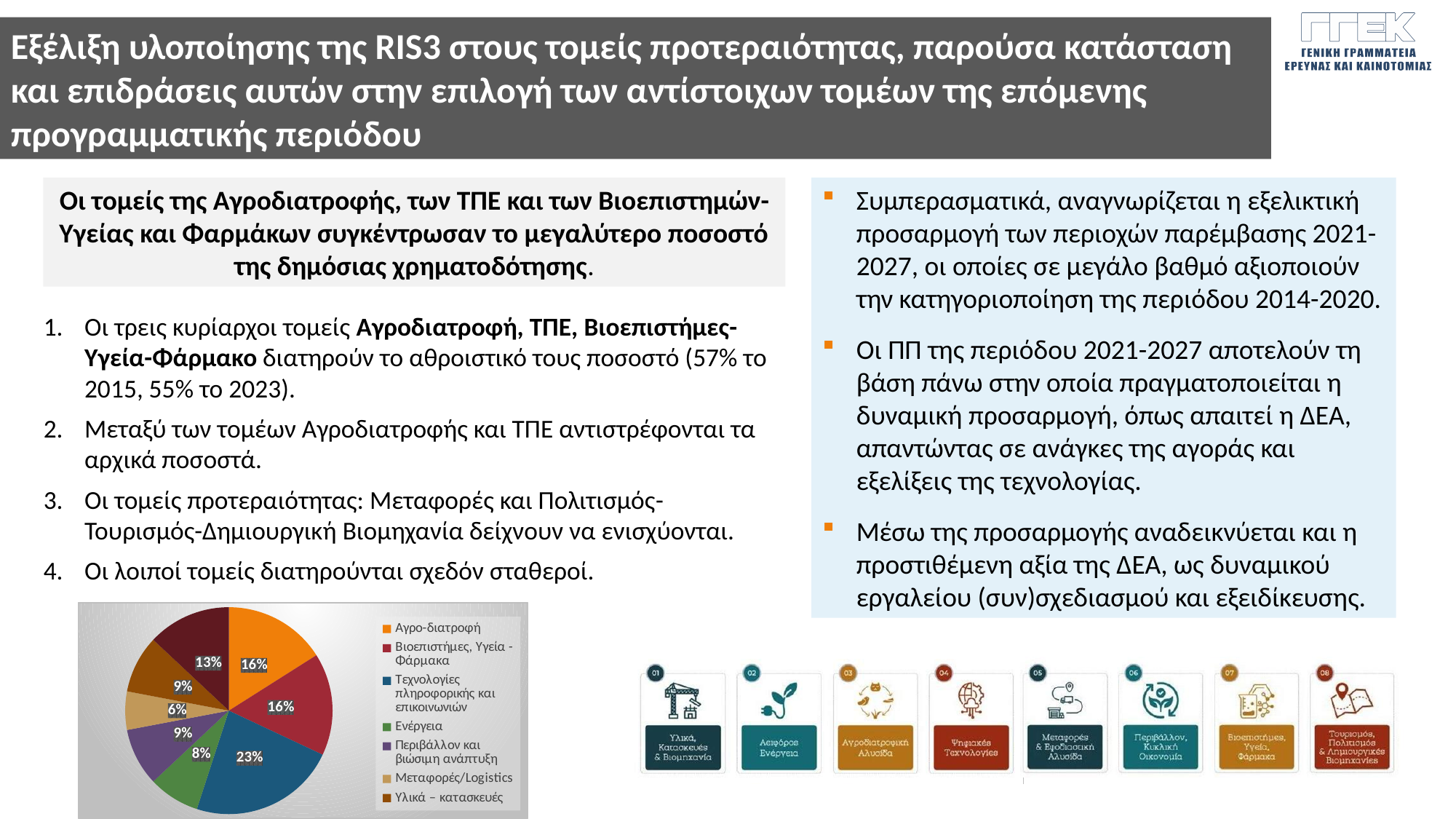
Which slice is larger in the pie chart: Ενέργεια or Περιβάλλον και βιώσιμη ανάπτυξη? Περιβάλλον και βιώσιμη ανάπτυξη How many slices does the pie chart have? 8 What percentage does the pie chart show for Τεχνολογίες πληροφορικής και επικοινωνιών? 23% What percentage does the pie chart show for Μεταφορές/Logistics? 6% What percentage does the pie chart show for Ενέργεια? 8% What colour is the Αγρο-διατροφή slice in the pie chart? Orange Which legend category has the smallest slice in the pie chart? Μεταφορές/Logistics What percentage does the pie chart show for Υλικά – κατασκευές? 9% What percentage does the pie chart show for Αγρο-διατροφή? 16% By how many percentage points does the Τεχνολογίες πληροφορικής και επικοινωνιών slice exceed the Ενέργεια slice? 15 percentage points What kind of chart is shown at the bottom left of the slide? Pie chart Which legend category has the largest slice in the pie chart? Τεχνολογίες πληροφορικής και επικοινωνιών